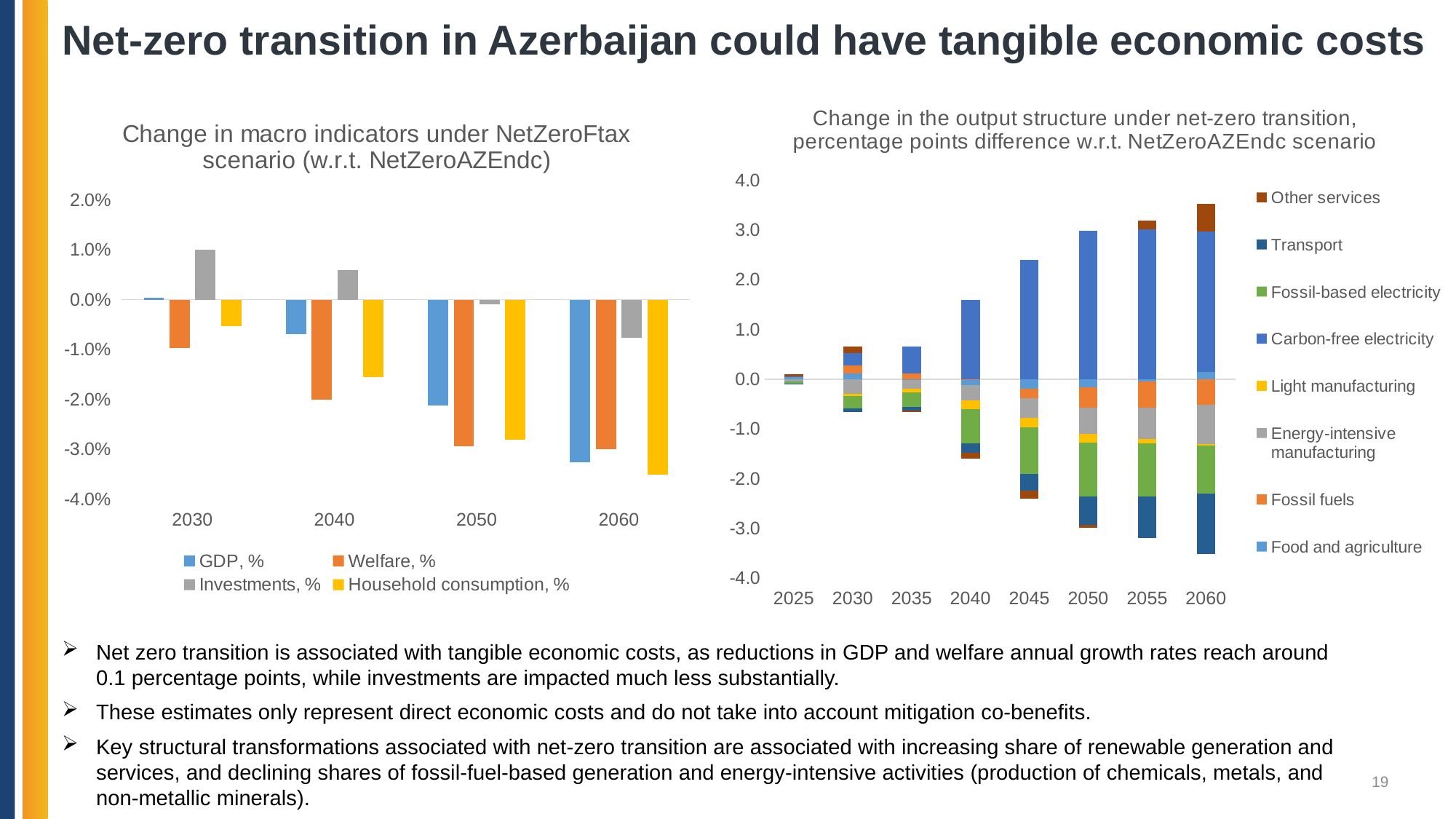
How many year categories are shown on the x axis of the right chart? 8 What kind of chart is the right chart, 'Change in the output structure under net-zero transition'? stacked bar chart In the left chart, is the value for GDP, % in 2060 greater or less than -3.0%? less What kind of chart is the left chart, 'Change in macro indicators under NetZeroFtax scenario'? bar chart In the left chart, how does the value for GDP, % change from 2030 to 2060? It falls In the right chart, which series is shown in yellow? Light manufacturing In the left chart, is the value for Household consumption, % in 2050 greater or less than -3.0%? greater How many series does the legend of the right chart list? 8 In the right chart, is the Carbon-free electricity segment for 2045 greater or less than 2.0? greater How many year categories are shown on the x axis of the left chart? 4 In the left chart, which series has the lowest value in 2060? Household consumption, % How many series does the legend of the left chart list? 4